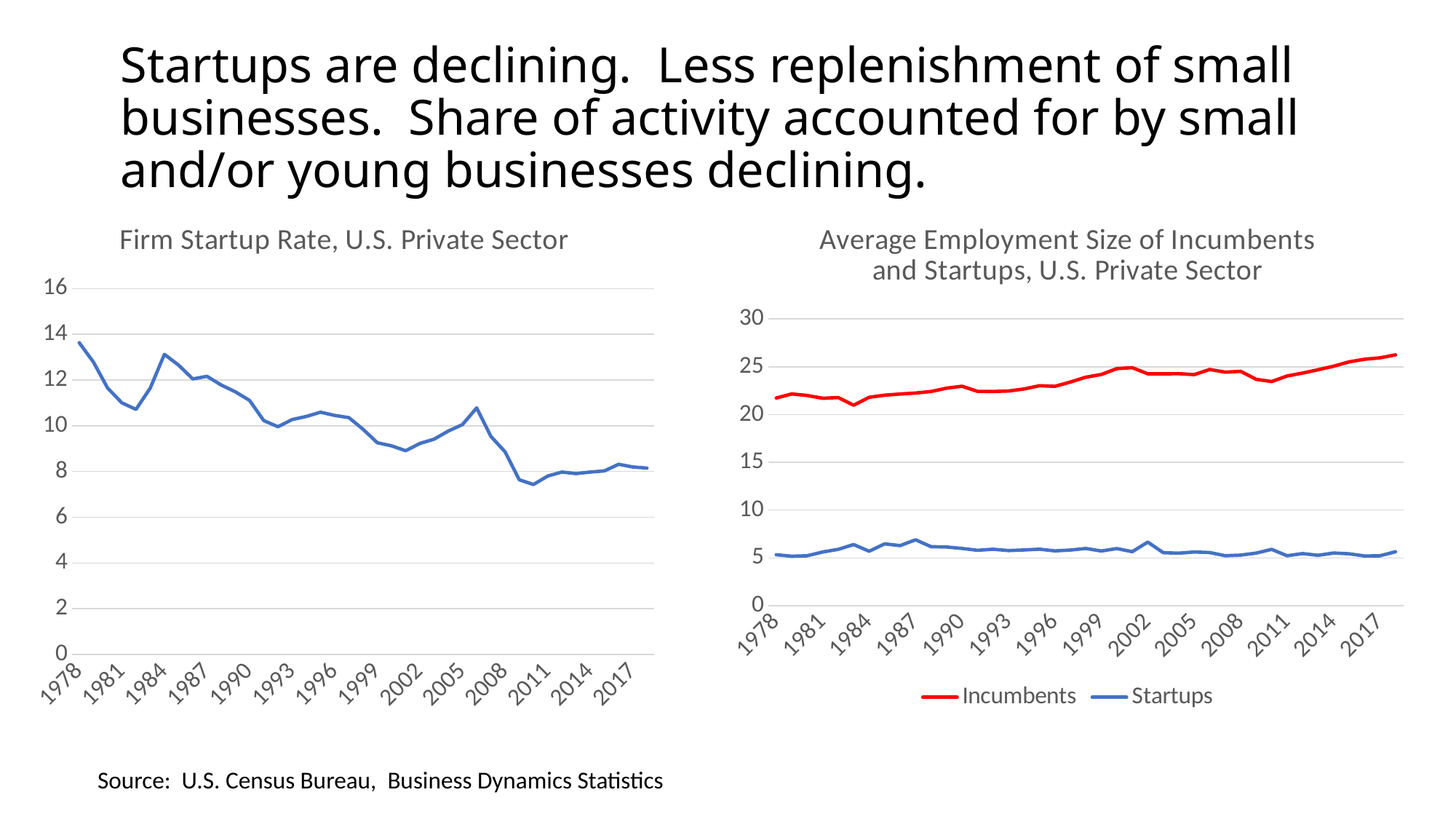
What is the title of the chart on the left side of the slide? Firm Startup Rate, U.S. Private Sector In the 'Average Employment Size of Incumbents and Startups, U.S. Private Sector' chart, is the Incumbents value for 2017 greater or less than 25? greater In the 'Firm Startup Rate, U.S. Private Sector' chart, is the value for 1978 greater or less than 12? greater In the 'Firm Startup Rate, U.S. Private Sector' chart, is the value for 1978 larger or smaller than the value for 2017? larger What kind of chart is the 'Firm Startup Rate, U.S. Private Sector' chart? line chart How many series does the legend list in the 'Average Employment Size of Incumbents and Startups, U.S. Private Sector' chart? 2 In the 'Average Employment Size of Incumbents and Startups, U.S. Private Sector' chart, is the Startups value for 2017 greater or less than 10? less In the 'Firm Startup Rate, U.S. Private Sector' chart, do values generally rise or fall from 1978 to 2017? fall In the 'Average Employment Size of Incumbents and Startups, U.S. Private Sector' chart, which series is shown in red? Incumbents In the 'Average Employment Size of Incumbents and Startups, U.S. Private Sector' chart, do the Incumbents values generally rise or fall from 1978 to 2017? rise In the 'Average Employment Size of Incumbents and Startups, U.S. Private Sector' chart, which series has the higher value in 2017, Incumbents or Startups? Incumbents